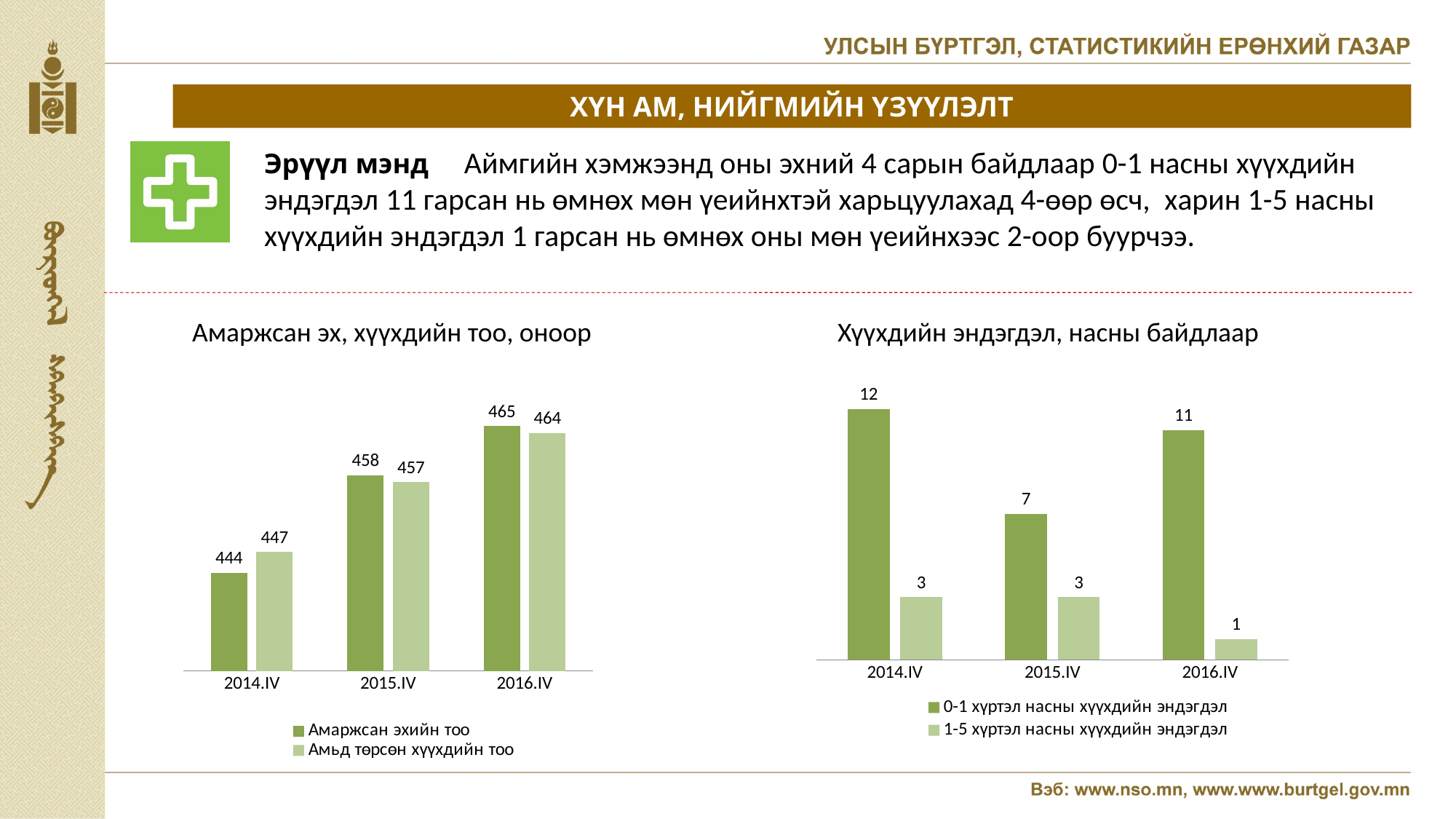
In the chart 'Амаржсан эх, хүүхдийн тоо, оноор', does 'Амаржсан эхийн тоо' rise or fall from 2014.IV to 2016.IV? rise In the chart 'Хүүхдийн эндэгдэл, насны байдлаар', what is the value of '1-5 хүртэл насны хүүхдийн эндэгдэл' for 2016.IV? 1 In the chart 'Хүүхдийн эндэгдэл, насны байдлаар', which year has the lowest value of '0-1 хүртэл насны хүүхдийн эндэгдэл'? 2015.IV In the chart 'Хүүхдийн эндэгдэл, насны байдлаар', what is the difference between '0-1 хүртэл насны хүүхдийн эндэгдэл' and '1-5 хүртэл насны хүүхдийн эндэгдэл' in 2014.IV? 9 In the chart 'Амаржсан эх, хүүхдийн тоо, оноор', what is the value of 'Амьд төрсөн хүүхдийн тоо' for 2016.IV? 464 In the chart 'Амаржсан эх, хүүхдийн тоо, оноор', what is the value of 'Амаржсан эхийн тоо' for 2014.IV? 444 In the chart 'Амаржсан эх, хүүхдийн тоо, оноор', what is the difference between 'Амаржсан эхийн тоо' in 2016.IV and in 2014.IV? 21 In the chart 'Хүүхдийн эндэгдэл, насны байдлаар', what is the value of '0-1 хүртэл насны хүүхдийн эндэгдэл' for 2015.IV? 7 In the chart 'Амаржсан эх, хүүхдийн тоо, оноор', which year has the highest value of 'Амаржсан эхийн тоо'? 2016.IV In the chart 'Хүүхдийн эндэгдэл, насны байдлаар', which is larger in 2016.IV: '0-1 хүртэл насны хүүхдийн эндэгдэл' or '1-5 хүртэл насны хүүхдийн эндэгдэл'? 0-1 хүртэл насны хүүхдийн эндэгдэл How many series does the legend of the chart 'Амаржсан эх, хүүхдийн тоо, оноор' list? 2 What type of chart is 'Хүүхдийн эндэгдэл, насны байдлаар'? bar chart